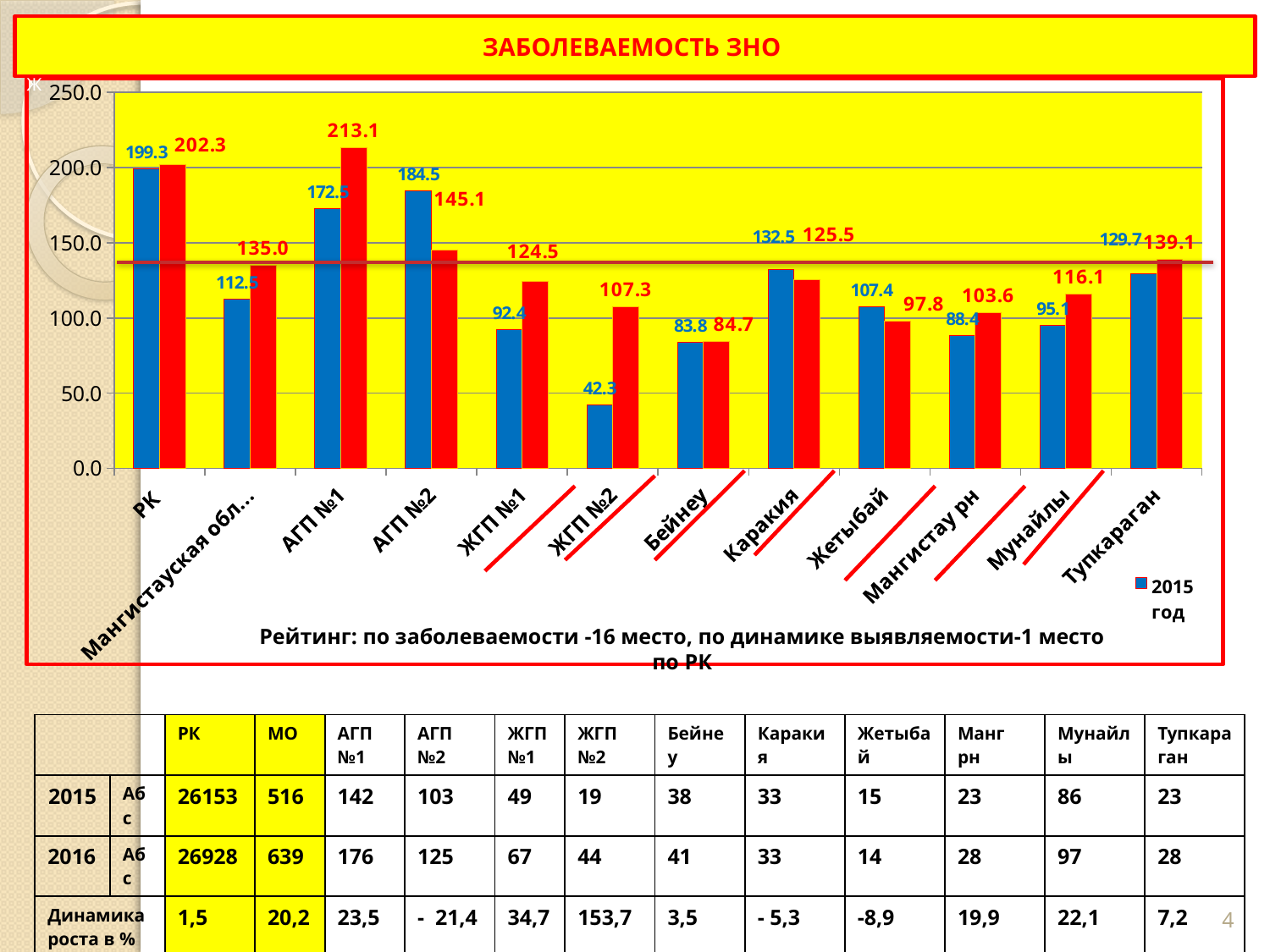
What is the difference between the red bar and the blue bar for ЖГП №2? 65.0 Which category has the highest red bar? АГП №1 What type of chart is shown on the slide? bar chart What is the title of the chart? ЗАБОЛЕВАЕМОСТЬ ЗНО What is the value of the blue (2015 год) bar for Тупкараган? 129.7 What is the value of the red bar for ЖГП №2? 107.3 What is the value of the blue (2015 год) bar for АГП №2? 184.5 Is the value of the red bar for Мунайлы greater or less than 100.0? greater Which category has the lowest blue (2015 год) bar? ЖГП №2 What is the difference between the red bar for АГП №1 and the red bar for АГП №2? 68.0 Which is larger for Каракия, the blue (2015 год) bar or the red bar? the blue bar How many categories are shown along the x axis of the chart? 12